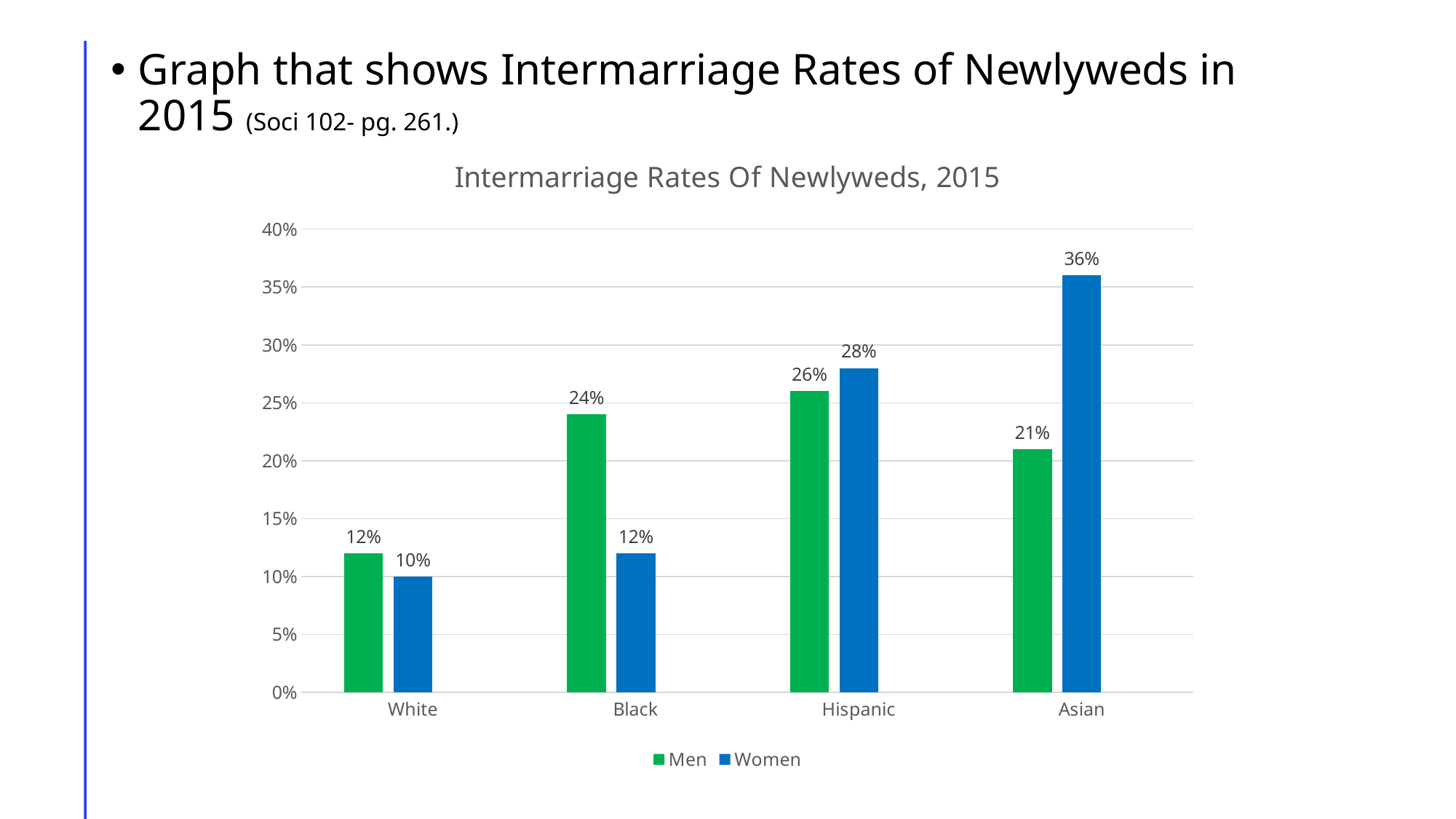
Which is larger, the rate for Black men or the rate for Black women? Black men What is the intermarriage rate for Asian women? 36% What is the difference between the Asian women's rate and the Asian men's rate? 15% Is the value for Hispanic women greater or less than 25%? greater What kind of chart is shown? Bar chart Which group has the lowest intermarriage rate for women? White How many series does the legend list? 2 How many groups are shown on the x axis? 4 What is the intermarriage rate for White women? 10% Which group has the highest intermarriage rate for men? Hispanic What is the intermarriage rate for Black men? 24% What is the title of the chart? Intermarriage Rates Of Newlyweds, 2015